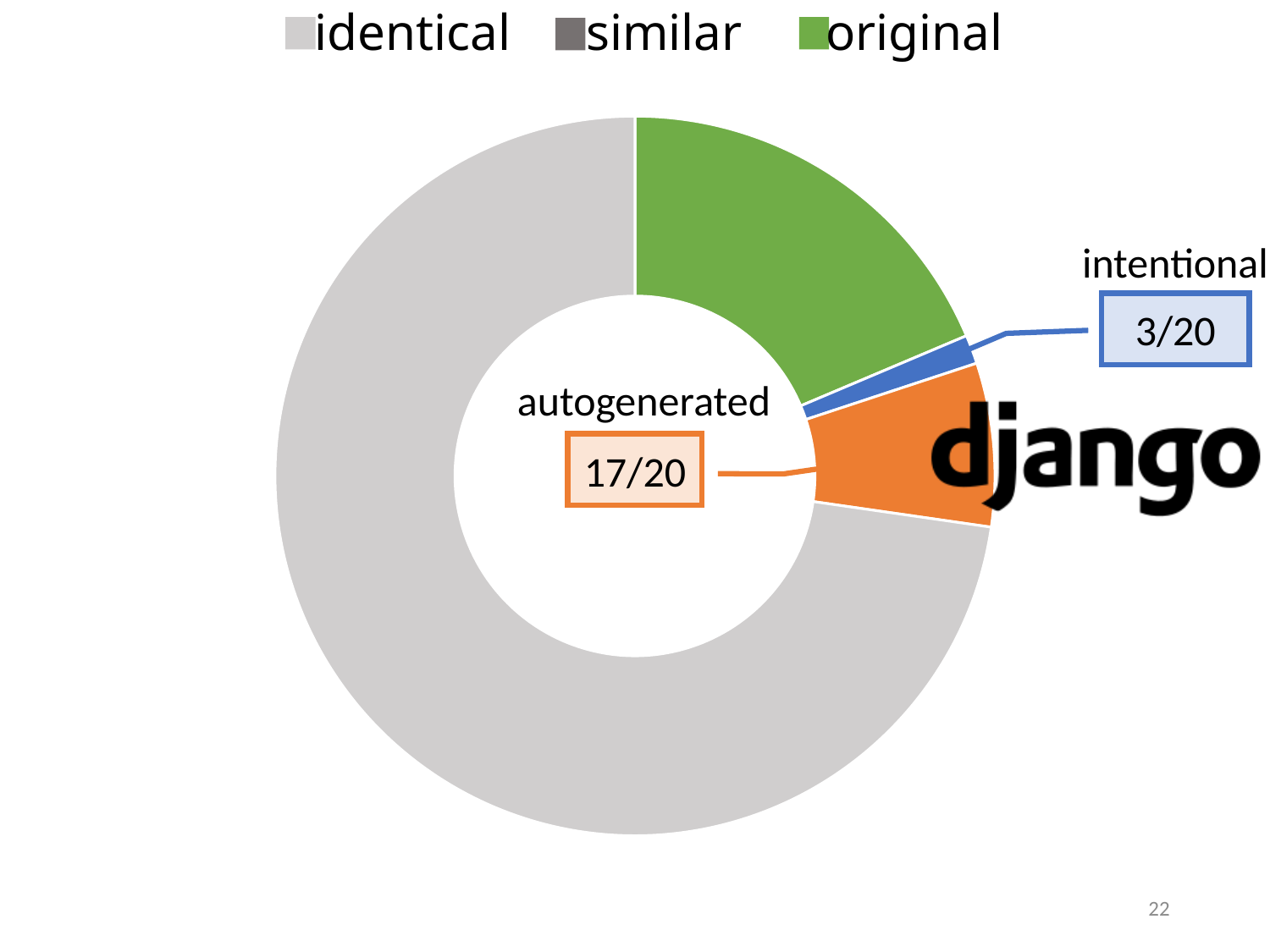
Which annotated slice is smaller, "intentional" or "autogenerated"? intentional What value is shown in the callout labelled "intentional"? 3/20 Which is larger, the "original" slice or the orange "autogenerated" slice? original Which category has the largest slice of the doughnut chart? identical Which project name is shown next to the chart? django Which is larger, the "identical" slice or the "original" slice? identical What colour represents the "original" category in the legend? Green What is the difference between the "autogenerated" and "intentional" counts shown in the callouts? 14 How many entries does the chart legend list? 3 What are the three legend entries of the chart? identical, similar, original What value is shown in the callout labelled "autogenerated"? 17/20 What kind of chart is shown on the slide? Doughnut (pie) chart